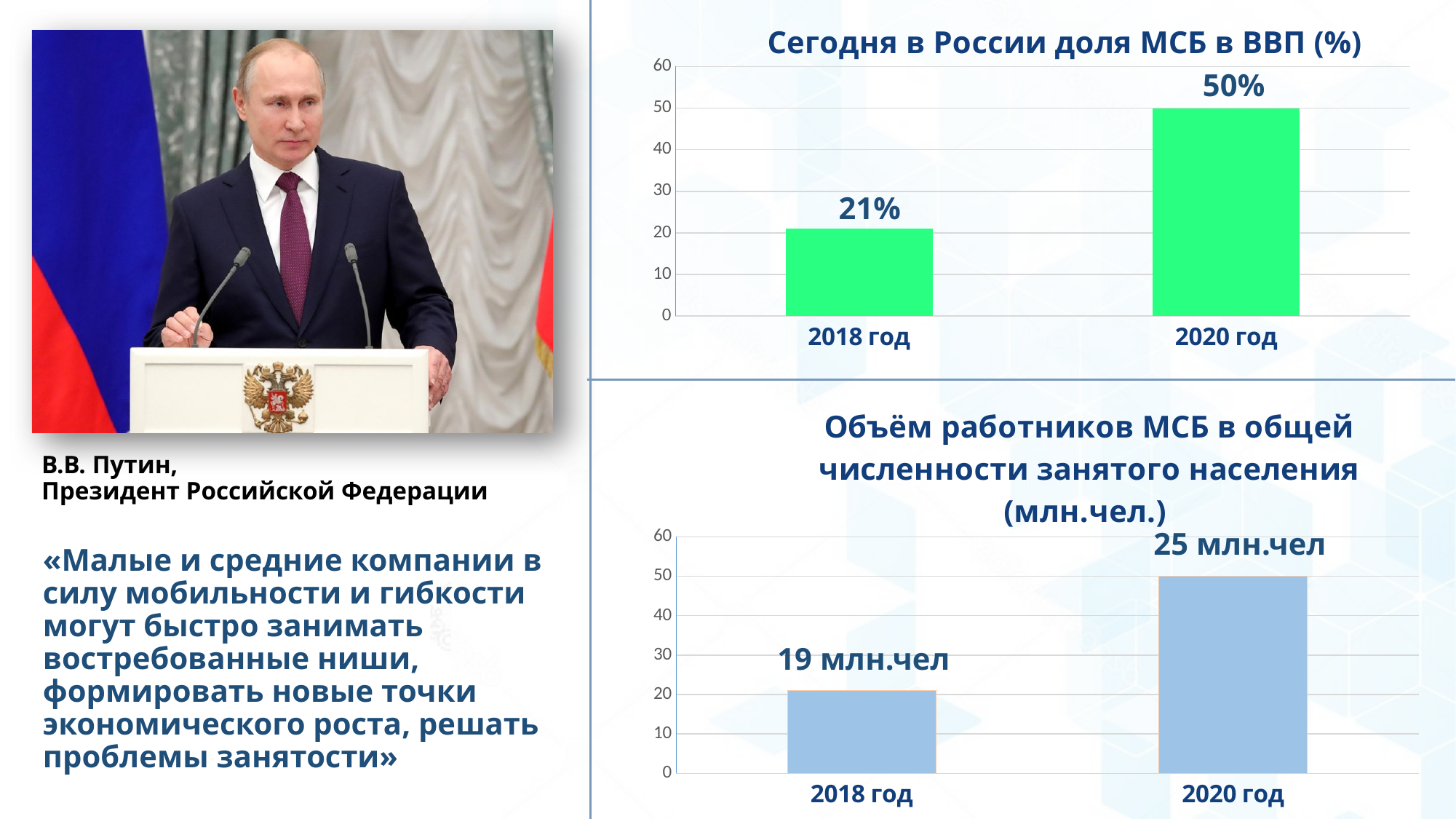
In the top chart "Сегодня в России доля МСБ в ВВП (%)", which year has the higher value? 2020 год In the bottom chart "Объём работников МСБ в общей численности занятого населения (млн.чел.)", which year has the lower labelled value? 2018 год In the bottom chart "Объём работников МСБ в общей численности занятого населения (млн.чел.)", what is the labelled value for 2018 год? 19 млн.чел In the bottom chart "Объём работников МСБ в общей численности занятого населения (млн.чел.)", do the values rise or fall from 2018 год to 2020 год? rise What colour are the bars in the top chart "Сегодня в России доля МСБ в ВВП (%)"? green How many charts are on the slide? 2 In the top chart "Сегодня в России доля МСБ в ВВП (%)", what is the value for 2020 год? 50% In the top chart "Сегодня в России доля МСБ в ВВП (%)", what is the value for 2018 год? 21% In the top chart "Сегодня в России доля МСБ в ВВП (%)", what is the difference between the 2020 год and 2018 год values? 29% In the top chart "Сегодня в России доля МСБ в ВВП (%)", how many categories are shown? 2 In the bottom chart "Объём работников МСБ в общей численности занятого населения (млн.чел.)", what is the labelled value for 2020 год? 25 млн.чел What kind of chart is the top chart "Сегодня в России доля МСБ в ВВП (%)"? bar chart